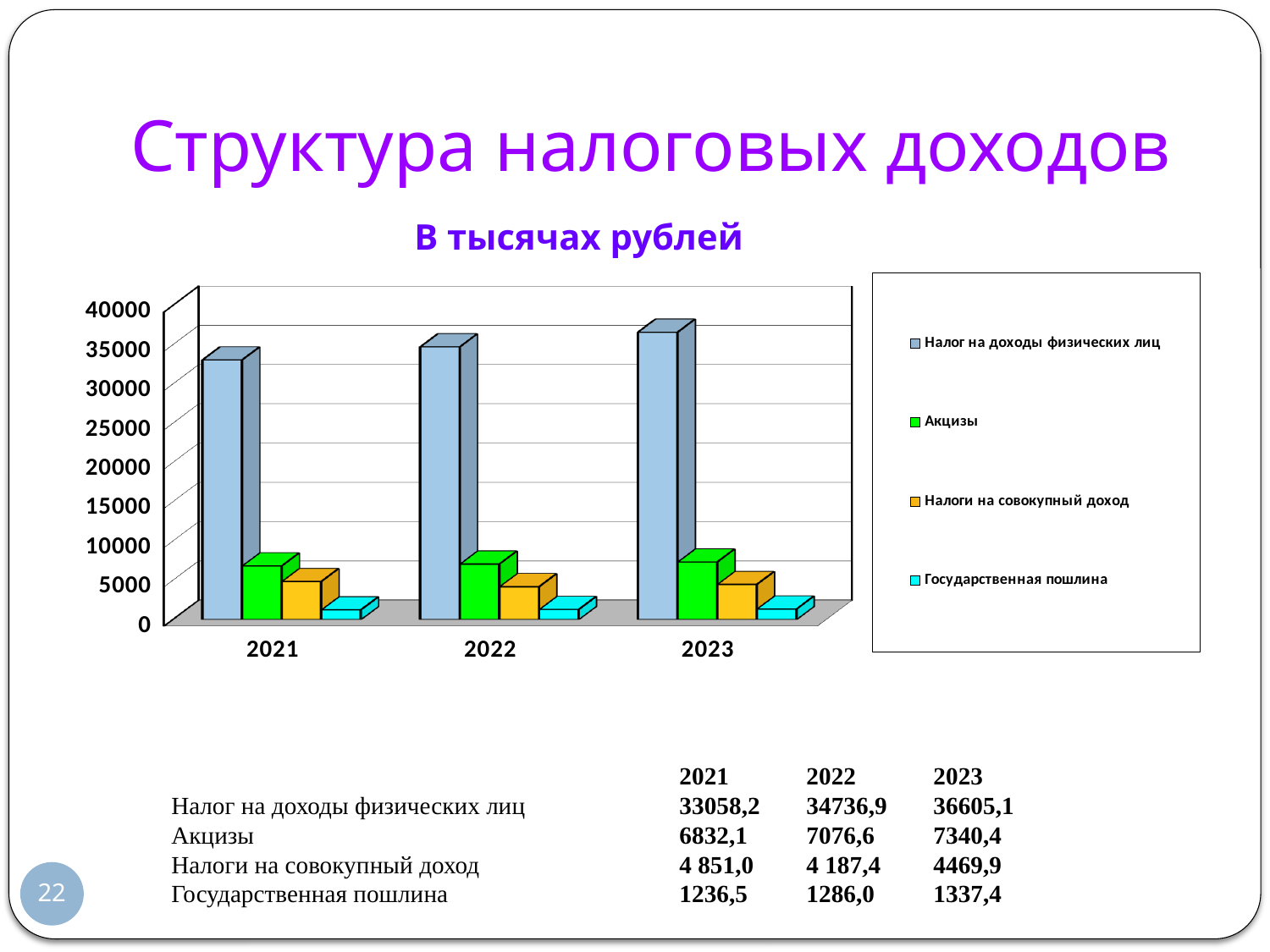
What is the value of Налог на доходы физических лиц for 2023? 36605,1 What type of chart is shown on the slide? bar chart Which is larger: Акцизы in 2021 or Налоги на совокупный доход in 2021? Акцизы in 2021 Which series has the lowest value in 2022? Государственная пошлина What unit is stated in the chart subtitle? В тысячах рублей By how much did Налог на доходы физических лиц increase from 2021 to 2023? 3546,9 Which series has the highest value in 2023? Налог на доходы физических лиц How many years (categories) are shown on the x axis? 3 What is the value of Государственная пошлина for 2021? 1236,5 How many series does the legend list? 4 What is the value of Акцизы for 2022? 7076,6 Does Налог на доходы физических лиц rise or fall from 2021 to 2023? rise